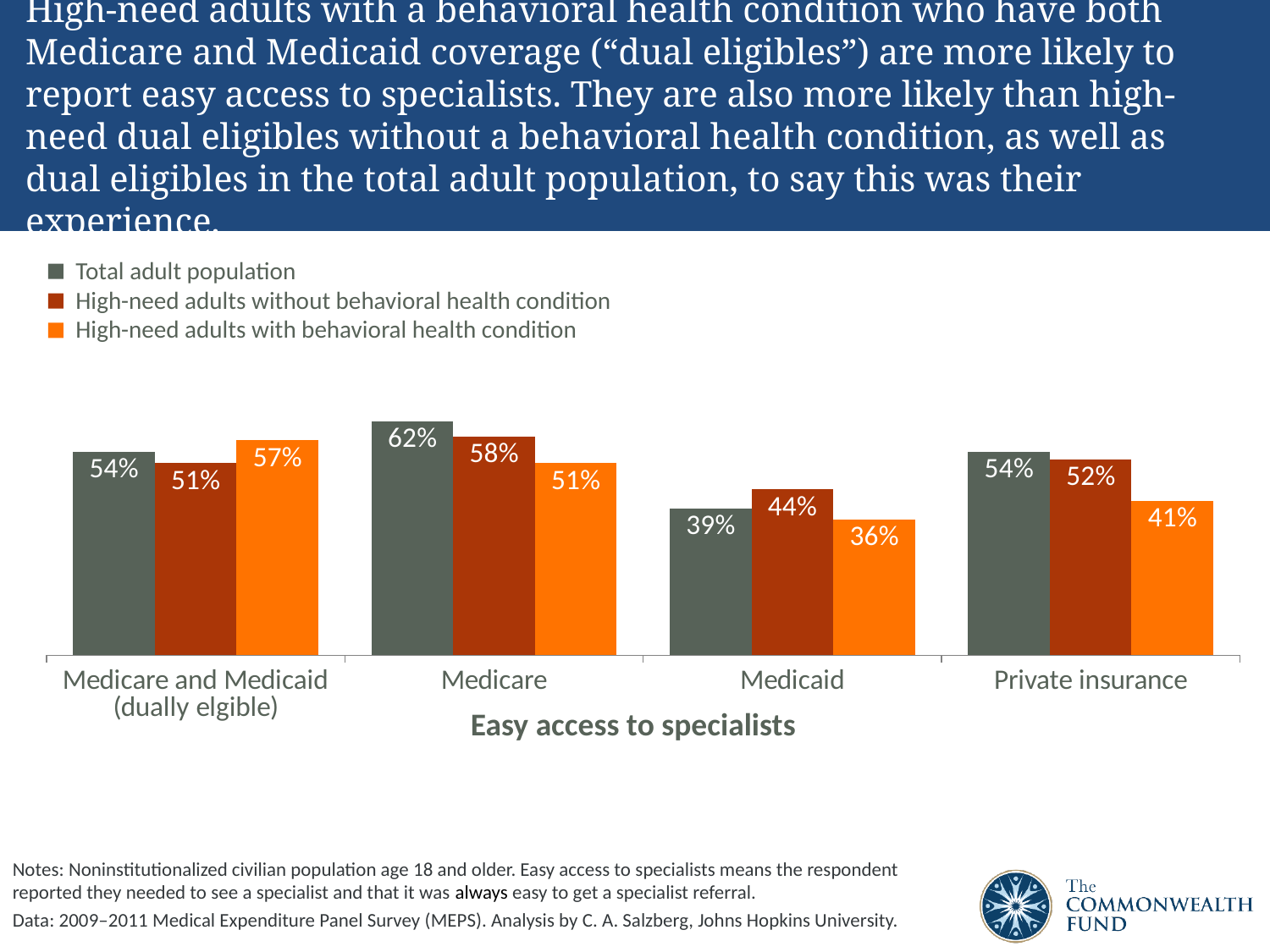
How many series does the legend list? 3 Which category has the highest value for Total adult population? Medicare What is the value for Total adult population in the Medicaid category? 39% What is the x-axis title of the chart? Easy access to specialists What kind of chart is shown on the slide? Bar chart In the Medicaid category, which is larger: the value for High-need adults without behavioral health condition or the value for Total adult population? High-need adults without behavioral health condition What is the value for High-need adults with behavioral health condition in the Medicare and Medicaid (dually elgible) category? 57% What is the value for High-need adults without behavioral health condition in the Private insurance category? 52% Which category has the lowest value for High-need adults with behavioral health condition? Medicaid How many categories are shown on the x axis? 4 Which series is shown in orange in the legend? High-need adults with behavioral health condition What is the difference between the Total adult population value and the High-need adults with behavioral health condition value in the Private insurance category? 13 percentage points